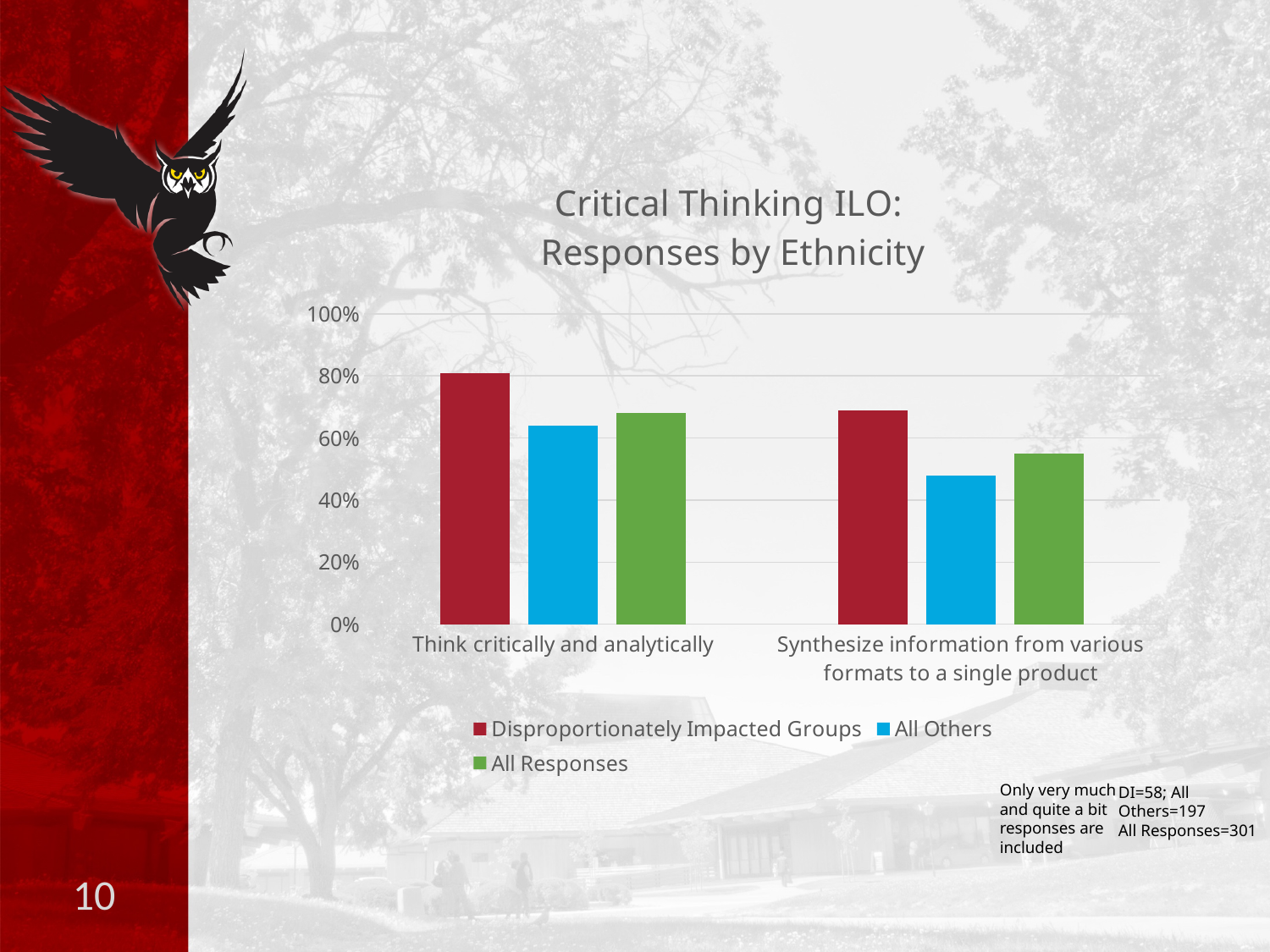
How many series does the legend list? 3 Which series has the lowest value for "Synthesize information from various formats to a single product"? All Others Which colour represents the All Responses series in the legend? green Is the value for All Responses on "Think critically and analytically" greater or less than 80%? less What kind of chart is shown on the slide? bar chart Do the values for All Others rise or fall from "Think critically and analytically" to "Synthesize information from various formats to a single product"? fall Is the value for All Others on "Synthesize information from various formats to a single product" greater or less than 60%? less What is the title of the chart? Critical Thinking ILO: Responses by Ethnicity How many categories are shown on the x axis? 2 For "Synthesize information from various formats to a single product", which is larger: Disproportionately Impacted Groups or All Responses? Disproportionately Impacted Groups Is the value for Disproportionately Impacted Groups on "Think critically and analytically" greater or less than 60%? greater Which series has the highest value for "Think critically and analytically"? Disproportionately Impacted Groups